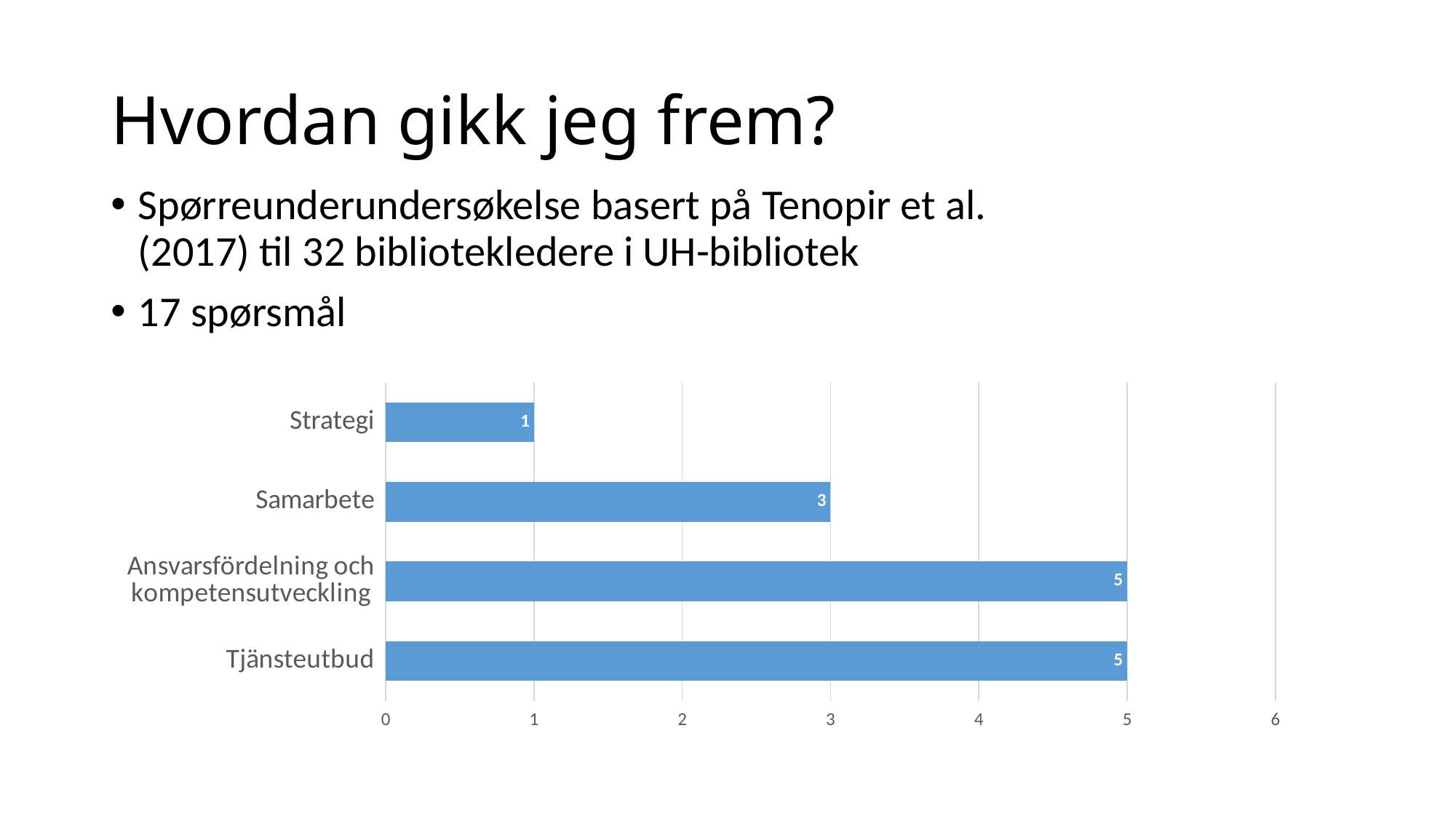
What is the highest value shown on the x axis? 6 Which category has the lowest value? Strategi What is the difference between the values for Samarbete and Strategi? 2 What is the value for Ansvarsfördelning och kompetensutveckling? 5 What kind of chart is shown on the slide? bar chart What is the value for Tjänsteutbud? 5 What is the value for Strategi? 1 What is the difference between the values for Tjänsteutbud and Samarbete? 2 What is the value for Samarbete? 3 Is the value for Samarbete greater or less than 2? greater How many categories are shown in the chart? 4 Which is larger, the value for Samarbete or the value for Strategi? Samarbete